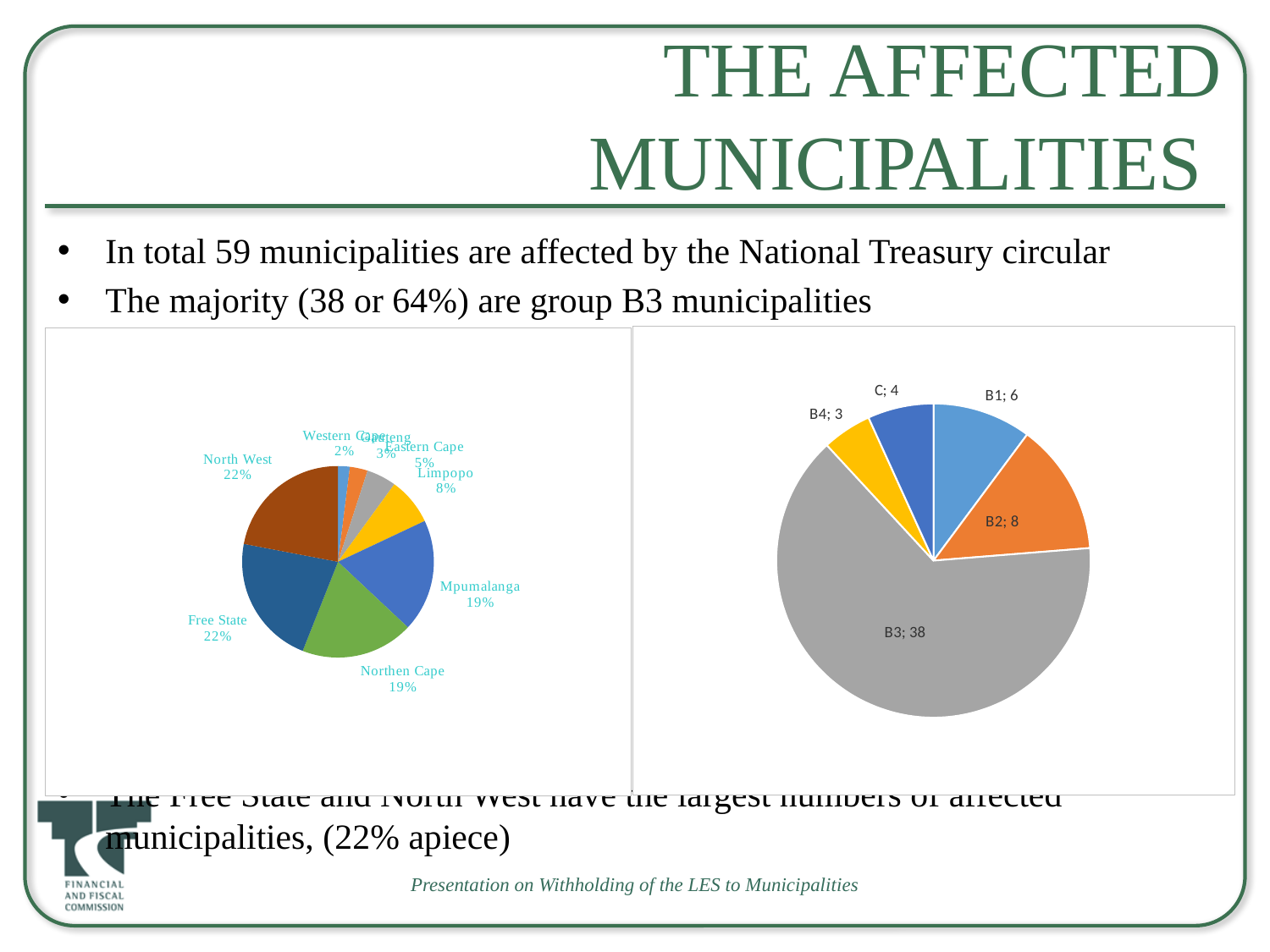
On the left pie chart, which province has the smallest share? Western Cape How many slices does the right pie chart have? 5 On the left pie chart, what share does Free State have? 22% On the left pie chart, what percentage is shown for Limpopo? 8% On the right pie chart, how many municipalities are in group B3? 38 On the right pie chart, which is larger, B1 or C? B1 On the left pie chart, which is larger, Mpumalanga or Limpopo? Mpumalanga On the right pie chart, which group has the largest slice? B3 On the right pie chart, what is the difference between the B2 and B1 values? 2 On the right pie chart, what is the total of all the slice values? 59 What kind of chart is the left chart? Pie chart On the right pie chart, which group has the smallest slice? B4